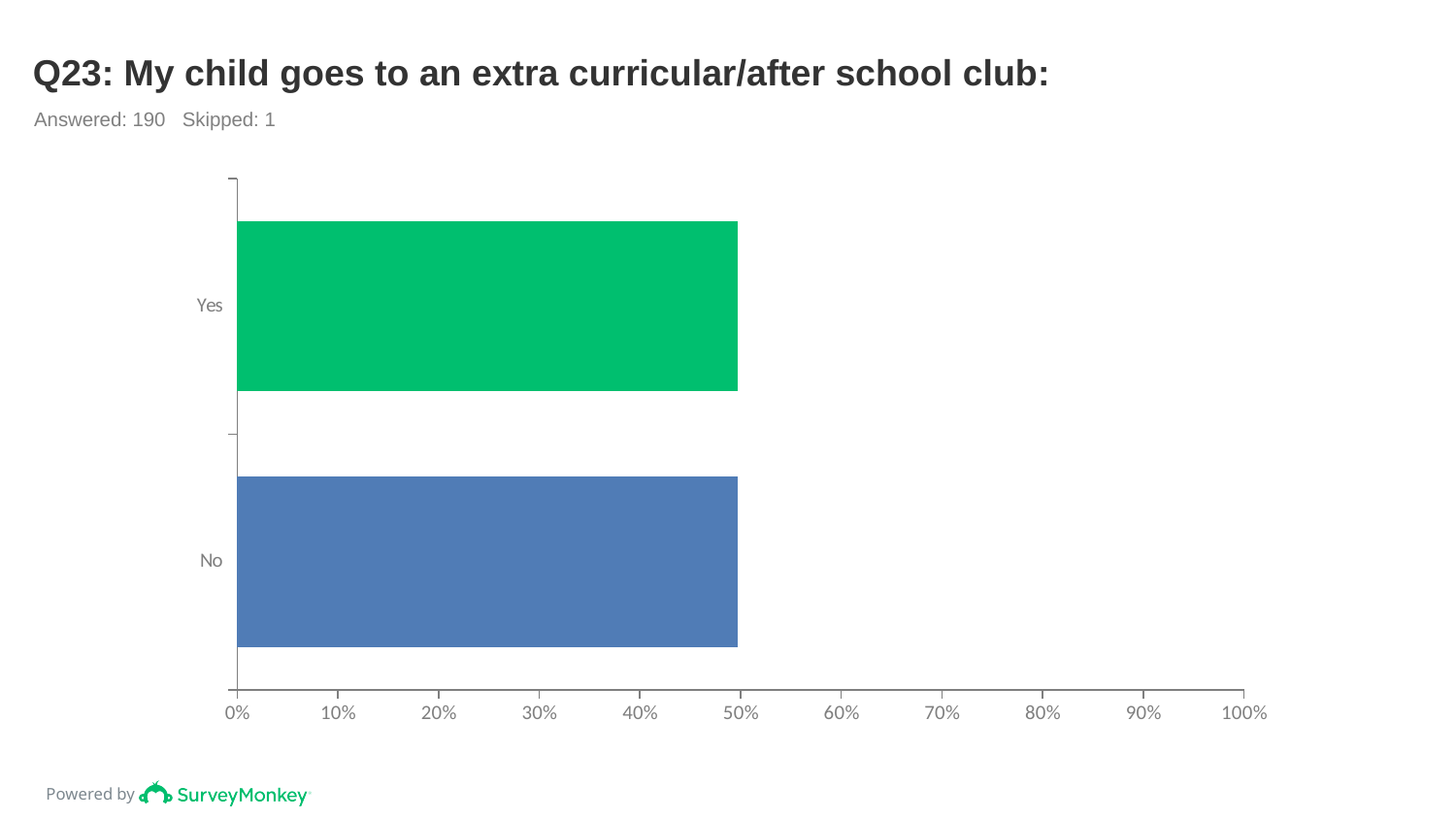
What is the highest value shown on the x axis? 100% What is the title of the chart? Q23: My child goes to an extra curricular/after school club: Is the value for Yes greater or less than 40%? greater What colour is the bar for Yes? green Is the value for No greater or less than 30%? greater Is the value for No greater or less than 60%? less What kind of chart is shown on the slide? bar chart How many categories are plotted in the chart? 2